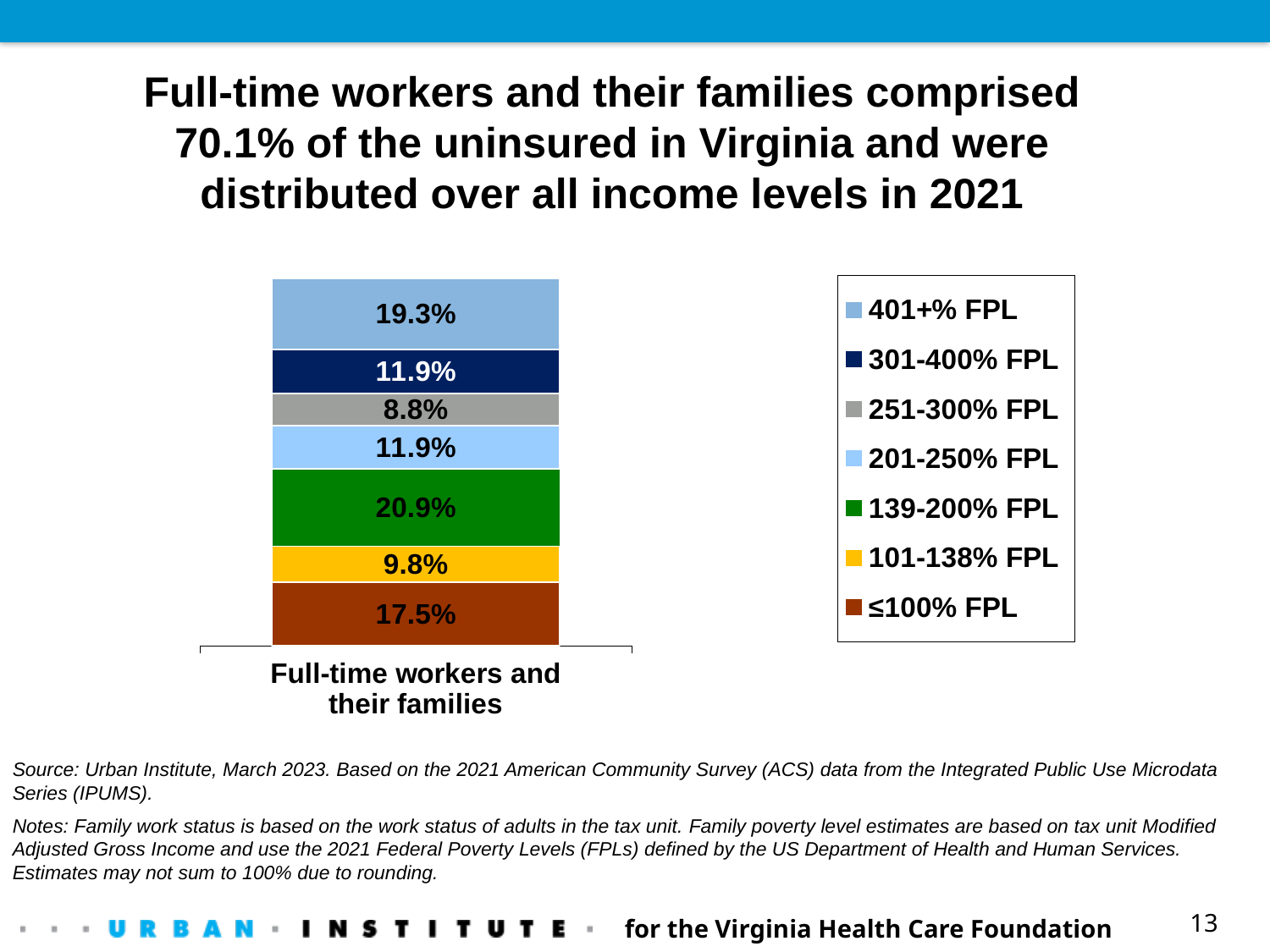
What is the difference between the 139-200% FPL share and the ≤100% FPL share? 3.4% What share of uninsured full-time workers and their families are at ≤100% FPL? 17.5% What colour is the 139-200% FPL segment in the chart? Green What is the total of all segments in the stacked bar? 100.1% What share of uninsured full-time workers and their families are at 401+% FPL? 19.3% What kind of chart is shown on the slide? Stacked bar chart What share of uninsured full-time workers and their families are at 139-200% FPL? 20.9% Which is larger, the share at 401+% FPL or the share at ≤100% FPL? 401+% FPL Which income level has the largest share of uninsured full-time workers and their families? 139-200% FPL What share of uninsured full-time workers and their families are at 251-300% FPL? 8.8% How many income level series does the legend list? 7 Which income level has the smallest share of uninsured full-time workers and their families? 251-300% FPL